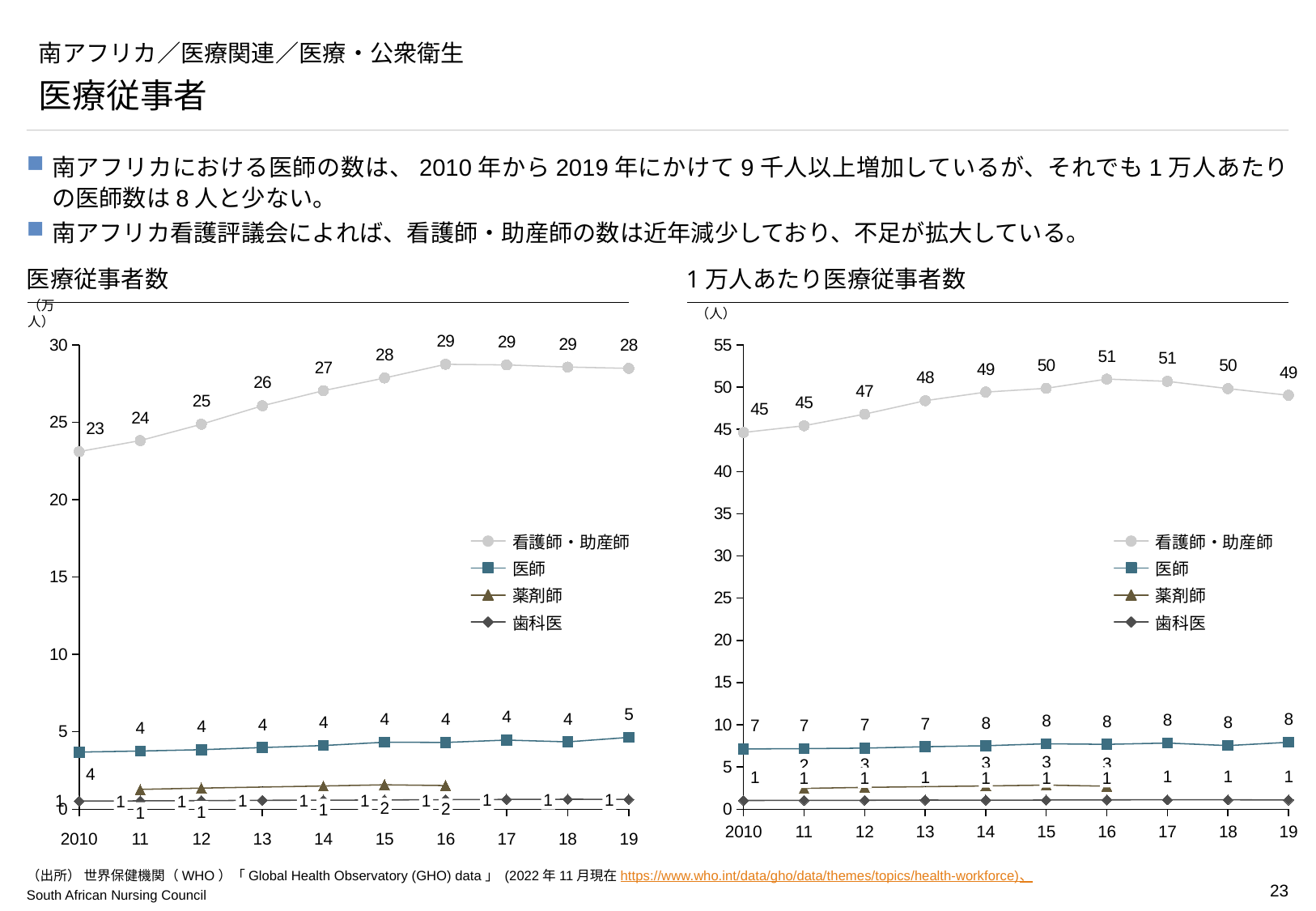
In the left chart (医療従事者数), by how much did the 看護師・助産師 value change from 2010 to 2016? 6 In the left chart (医療従事者数), what is the value for 看護師・助産師 in 2010? 23 In the left chart (医療従事者数), what is the value for 医師 in 19? 5 In the right chart (1万人あたり医療従事者数), what is the difference between the 看護師・助産師 values in 2010 and 2016? 6 In the right chart (1万人あたり医療従事者数), what is the value for 歯科医 in 19? 1 In the right chart (1万人あたり医療従事者数), what is the value for 医師 in 2010? 7 In the right chart (1万人あたり医療従事者数), what is the value for 看護師・助産師 in 2016? 51 In the left chart (医療従事者数), in which year is the 看護師・助産師 value lowest? 2010 What kind of chart is the right chart (1万人あたり医療従事者数)? Line chart In the right chart (1万人あたり医療従事者数), is the 看護師・助産師 value in 2010 greater or less than 40? greater How many series does the legend of the left chart (医療従事者数) list? 4 In the left chart (医療従事者数), what is the value for 看護師・助産師 in 2016? 29